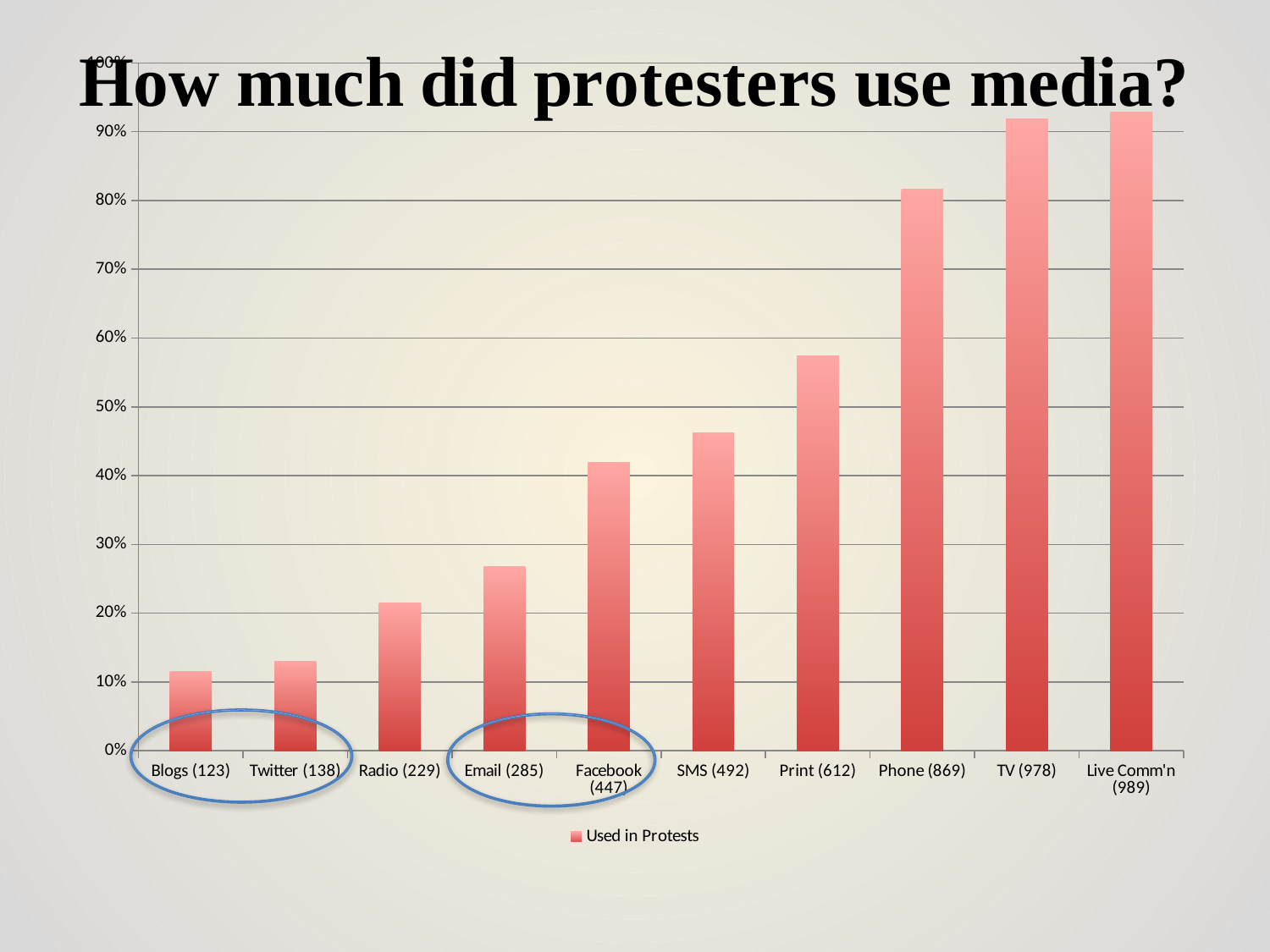
Which has a larger value, Phone (869) or Print (612)? Phone (869) What is the legend entry for the series in the chart? Used in Protests Which has a larger value, Facebook (447) or Twitter (138)? Facebook (447) What kind of chart is shown on the slide? bar chart Is the value for Print (612) greater or less than 50%? greater Is the value for Phone (869) greater or less than 70%? greater How many series does the chart's legend list? 1 What is the title of the slide containing the chart? How much did protesters use media? Is the value for SMS (492) greater or less than 50%? less Do the bar values rise or fall moving from left to right along the x axis? rise How many categories are plotted on the x axis of the chart? 10